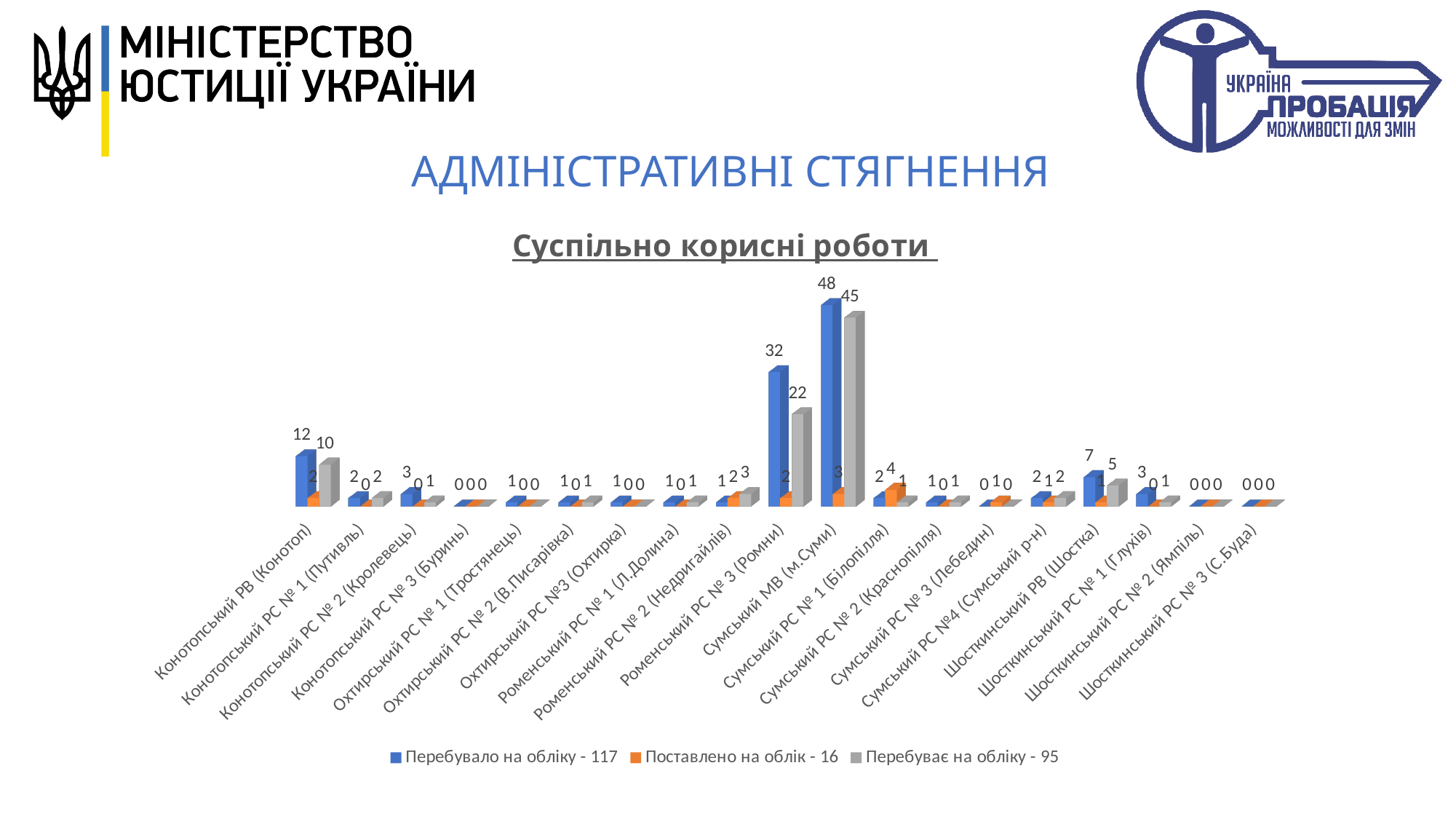
What is the difference between the "Перебувало на обліку - 117" values for Сумський МВ (м.Суми) and Роменський РС № 3 (Ромни)? 16 How many categories are shown on the x axis? 19 Which is larger for Шосткинський РВ (Шостка): "Перебувало на обліку - 117" or "Перебуває на обліку - 95"? Перебувало на обліку - 117 What is the value of "Перебуває на обліку - 95" for Конотопський РВ (Конотоп)? 10 Which category has the highest value for "Перебувало на обліку - 117"? Сумський МВ (м.Суми) What is the difference between the "Перебувало на обліку - 117" and "Перебуває на обліку - 95" values for Сумський МВ (м.Суми)? 3 What is the value of "Перебуває на обліку - 95" for Роменський РС № 3 (Ромни)? 22 How many series does the legend list? 3 What type of chart is shown under the title "Суспільно корисні роботи"? bar chart What is the value of "Перебувало на обліку - 117" for Сумський МВ (м.Суми)? 48 What is the value of "Поставлено на облік - 16" for Сумський РС № 1 (Білопілля)? 4 What colour are the bars for the series "Поставлено на облік - 16"? orange